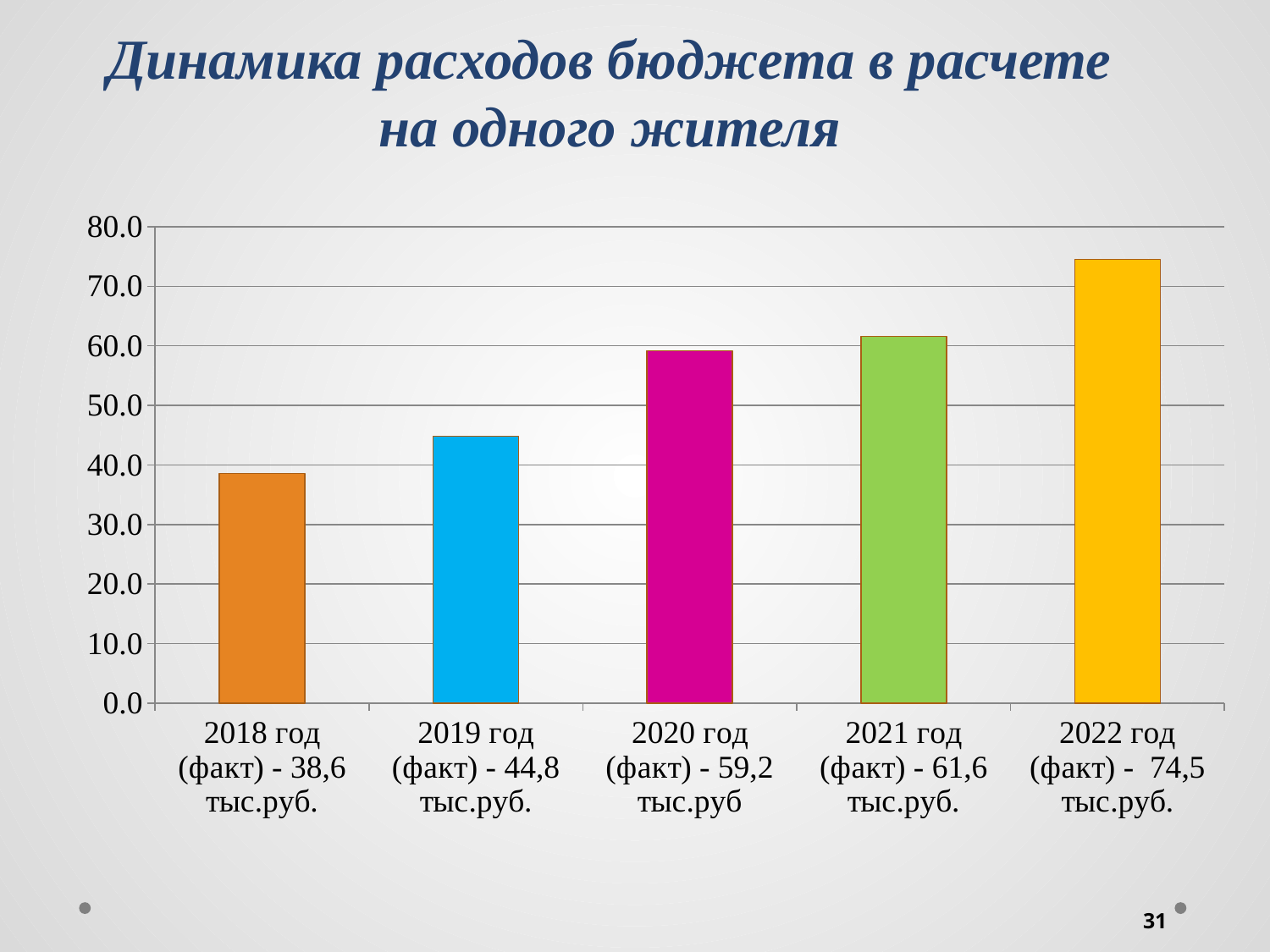
Do the values rise or fall from 2018 год to 2022 год? rise How many years are shown on the chart? 5 Which year has the lowest value? 2018 год What is the value for 2018 год? 38,6 тыс.руб. What is the difference between the values for 2020 год and 2019 год? 14,4 тыс.руб. What is the difference between the values for 2022 год and 2018 год? 35,9 тыс.руб. What is the value for 2022 год? 74,5 тыс.руб. Which is larger, the value for 2019 год or the value for 2021 год? 2021 год Which year has the highest value? 2022 год What kind of chart is shown on the slide? bar chart Is the value for 2021 год greater or less than 60.0? greater What is the value for 2020 год? 59,2 тыс.руб